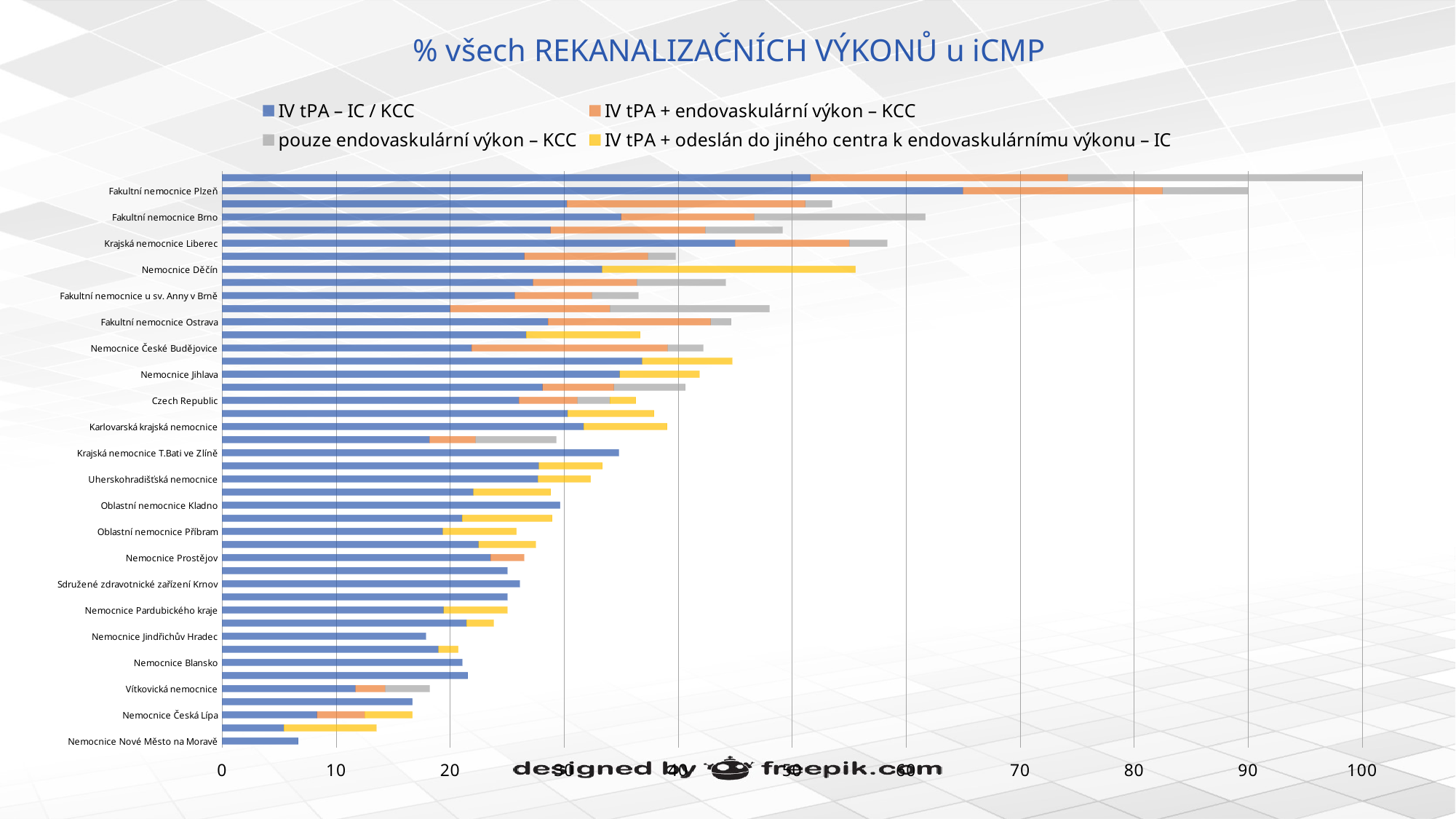
Which has a larger total value, Fakultní nemocnice Plzeň or Nemocnice Nové Město na Moravě? Fakultní nemocnice Plzeň Do the total bar lengths generally increase or decrease going from the top of the chart to the bottom? decrease What kind of chart is shown on the slide? bar chart Is the total value for Czech Republic greater or less than 30? greater Is the total value for Vítkovická nemocnice greater or less than 20? less Is the total value for Nemocnice Děčín greater or less than 50? greater How many series does the legend list? 4 Which colour represents the series "IV tPA – IC / KCC" in the legend? blue What is the title of the chart? % všech REKANALIZAČNÍCH VÝKONŮ u iCMP